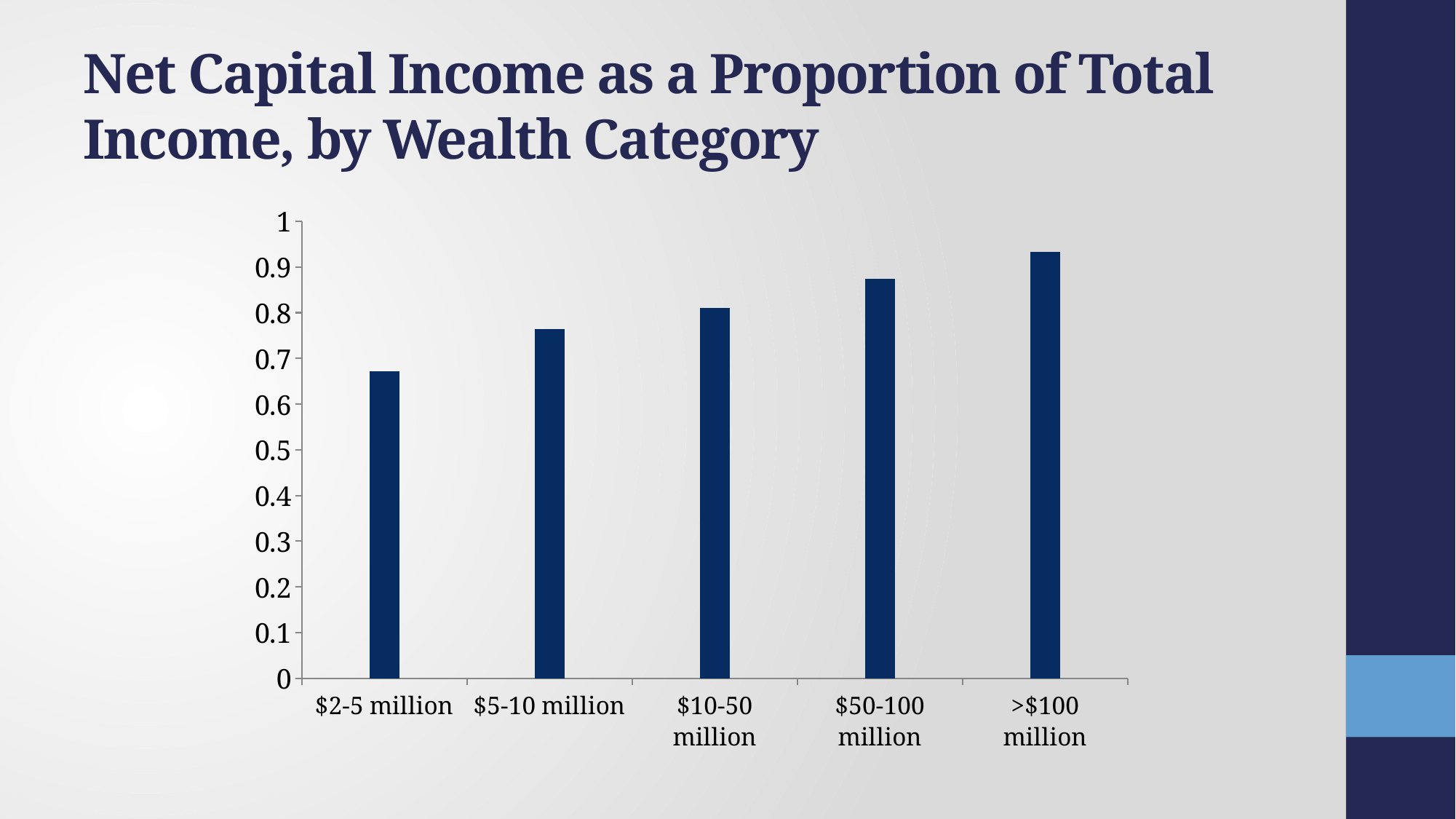
What kind of chart is shown on the slide? bar chart Is the value for $5-10 million greater or less than 0.8? less Which wealth category has the highest net capital income proportion? >$100 million Is the value for $50-100 million greater or less than 0.8? greater Is the value for >$100 million greater or less than 0.9? greater Which wealth category has the lowest net capital income proportion? $2-5 million Do the values rise or fall as the wealth category increases along the x axis? rise Which is larger, the value for $10-50 million or the value for $5-10 million? $10-50 million What is the title of the chart on the slide? Net Capital Income as a Proportion of Total Income, by Wealth Category How many wealth categories are shown on the x axis? 5 Which is larger, the value for $2-5 million or the value for $50-100 million? $50-100 million